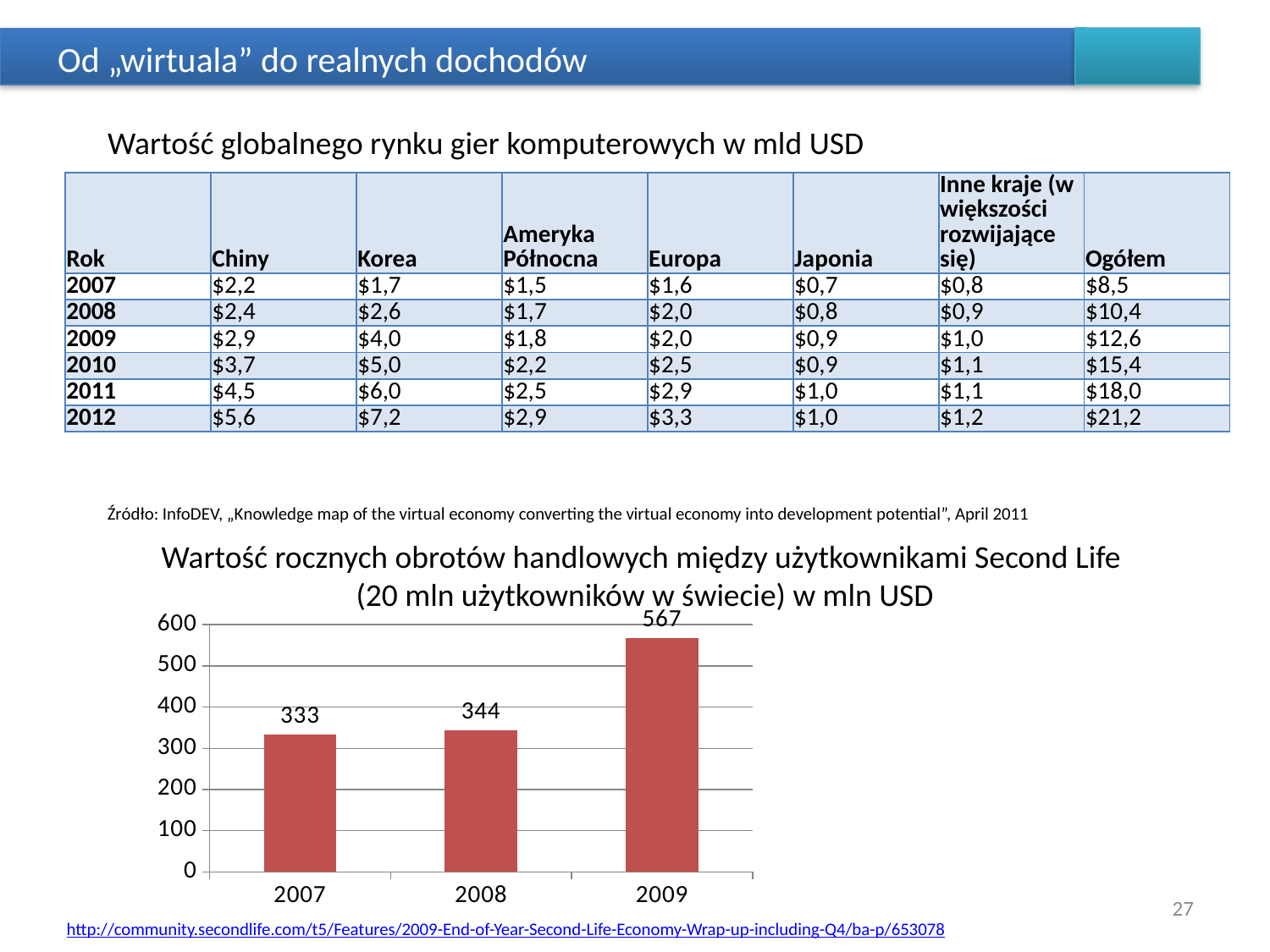
What is the difference between the values for 2009 and 2008 in the bar chart? 223 What type of chart is shown on the slide? bar chart Which is larger in the bar chart, the value for 2009 or the value for 2007? 2009 What is the value for 2008 in the bar chart? 344 What is the value for 2009 in the bar chart? 567 How many years are shown on the x axis of the bar chart? 3 Is the value for 2009 in the bar chart greater or less than 500? greater What is the difference between the values for 2008 and 2007 in the bar chart? 11 Which year has the lowest value in the bar chart? 2007 Which year has the highest value in the bar chart? 2009 What is the value for 2007 in the bar chart? 333 Do the values in the bar chart rise or fall from 2007 to 2009? rise